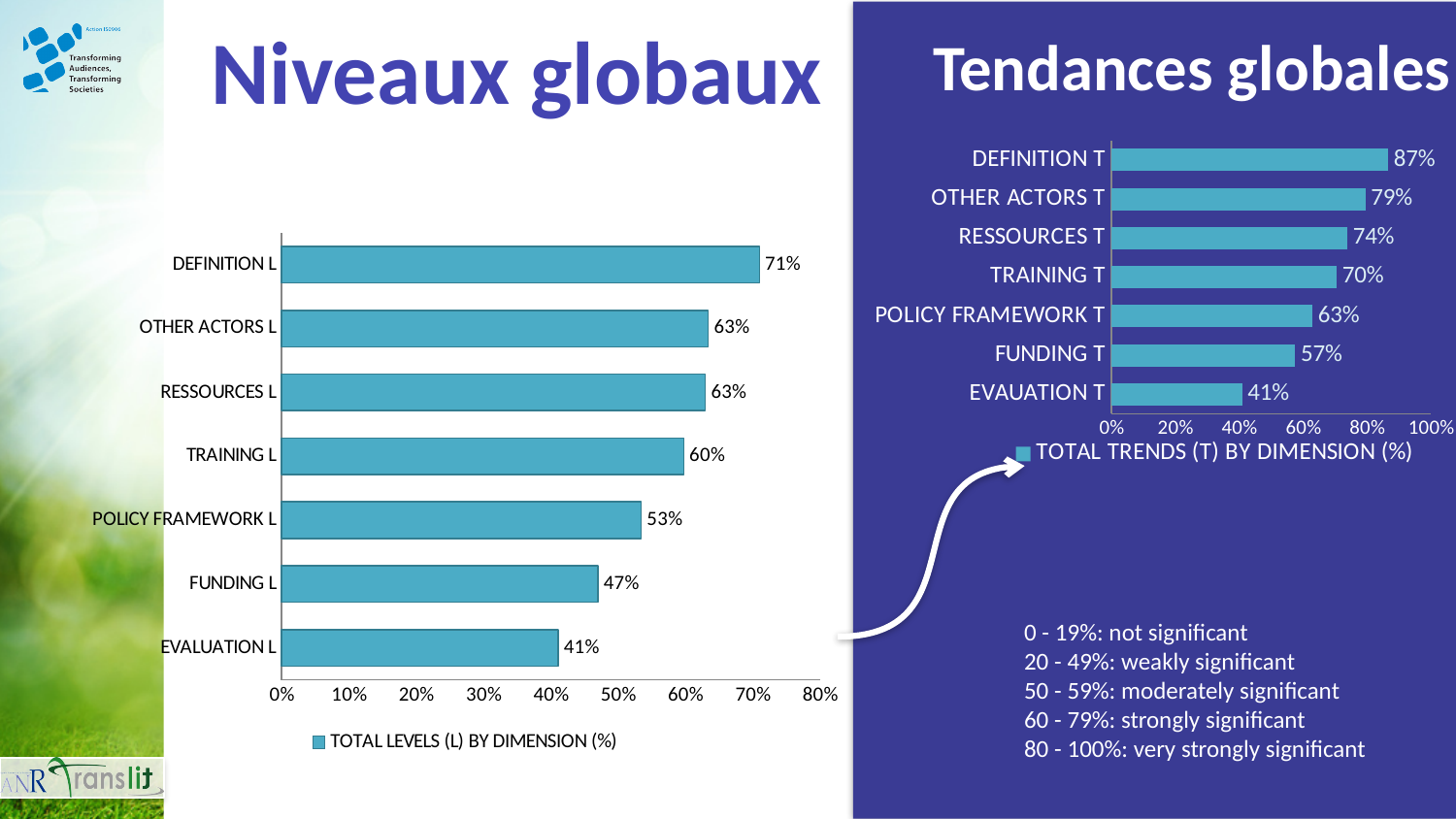
In the left chart (Niveaux globaux), what is the value for FUNDING L? 47% In the left chart (Niveaux globaux), how many categories are plotted? 7 In the right chart (Tendances globales), which category has the highest value? DEFINITION T In the left chart (Niveaux globaux), what is the value for DEFINITION L? 71% What type of chart is the right chart (Tendances globales)? Bar chart In the left chart (Niveaux globaux), what is the difference between DEFINITION L and EVALUATION L? 30% In the left chart (Niveaux globaux), which category has the lowest value? EVALUATION L What is the legend entry of the left chart (Niveaux globaux)? TOTAL LEVELS (L) BY DIMENSION (%) In the right chart (Tendances globales), which is larger: RESSOURCES T or TRAINING T? RESSOURCES T In the right chart (Tendances globales), what is the difference between DEFINITION T and FUNDING T? 30% In the right chart (Tendances globales), what is the value for OTHER ACTORS T? 79% In the right chart (Tendances globales), what is the value for POLICY FRAMEWORK T? 63%